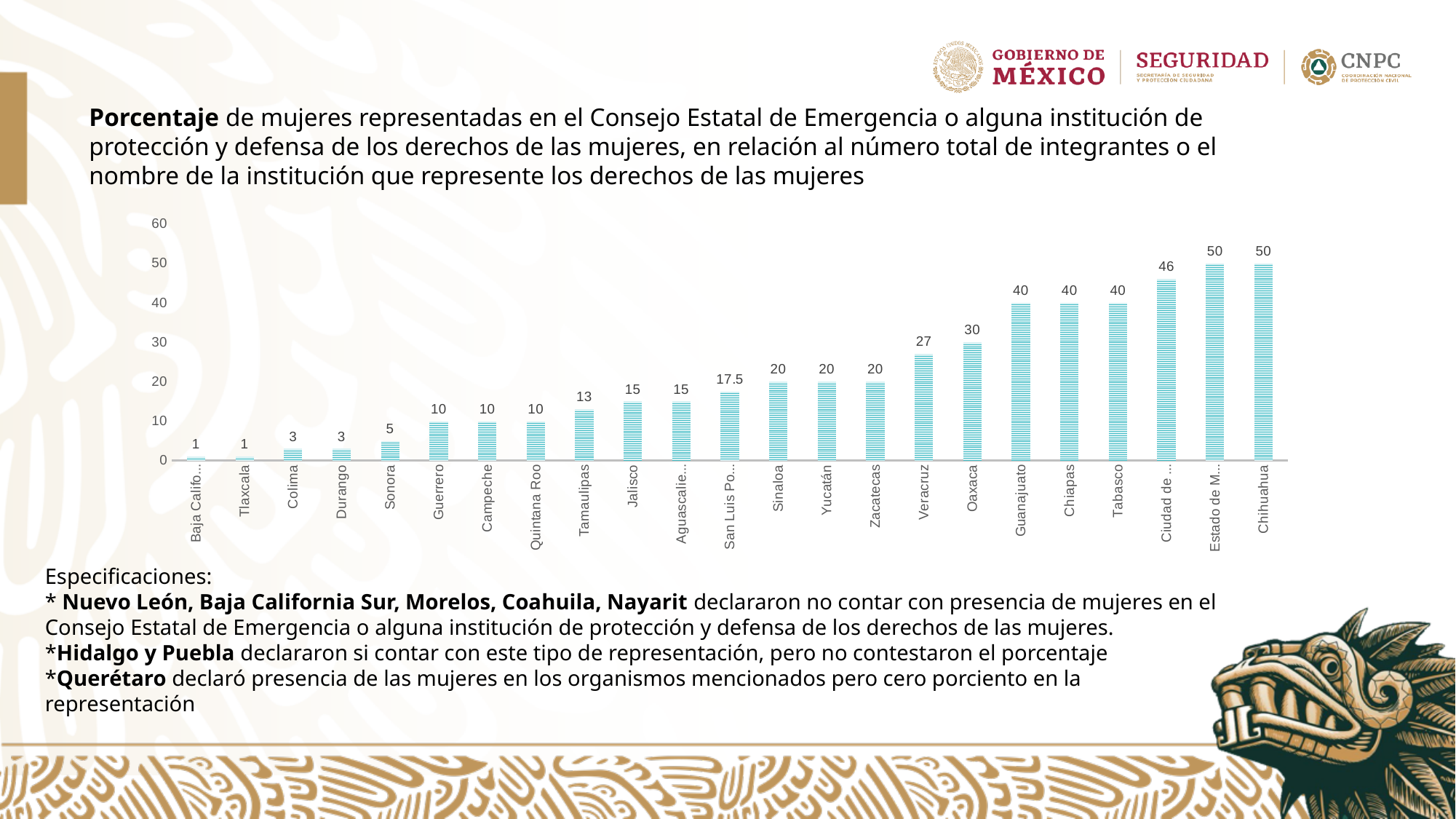
What is the value for Sonora? 5 What is the difference between the values for Guanajuato and Jalisco? 25 What is the difference between the values for Oaxaca and Veracruz? 3 Is the value for Chiapas greater or less than 30? greater Do the values rise or fall from left to right along the x axis? rise What is the value for Chihuahua? 50 What is the value for Tamaulipas? 13 What is the value for Oaxaca? 30 What is the value for Veracruz? 27 How many states (bars) are shown in the chart? 23 What kind of chart is shown on the slide? bar chart Which has a larger value, Tabasco or Zacatecas? Tabasco